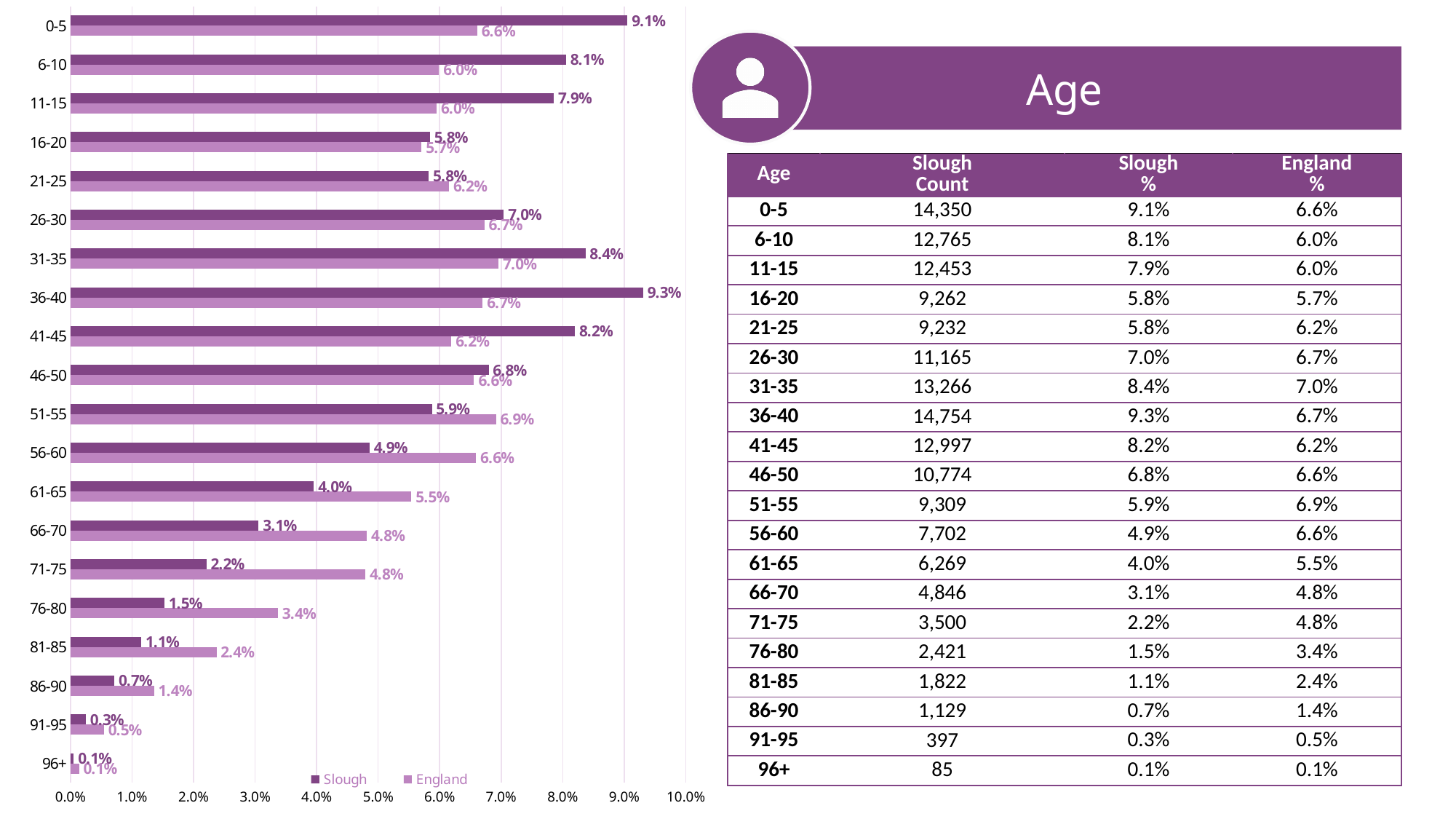
What is the difference between the England and Slough values for the 71-75 age group? 2.6% Is the Slough value for the 41-45 age group greater or less than 8.0%? greater What is the England value for the 51-55 age group? 6.9% Which is larger for the 56-60 age group, the Slough value or the England value? England What is the Slough value for the 36-40 age group? 9.3% Which age group has the lowest England value? 96+ What kind of chart is shown on the slide? bar chart How many age groups are shown on the chart? 20 How many series does the chart legend list? 2 Which age group has the highest Slough value? 36-40 What is the difference between the Slough and England values for the 0-5 age group? 2.5% What are the two series named in the chart legend? Slough and England